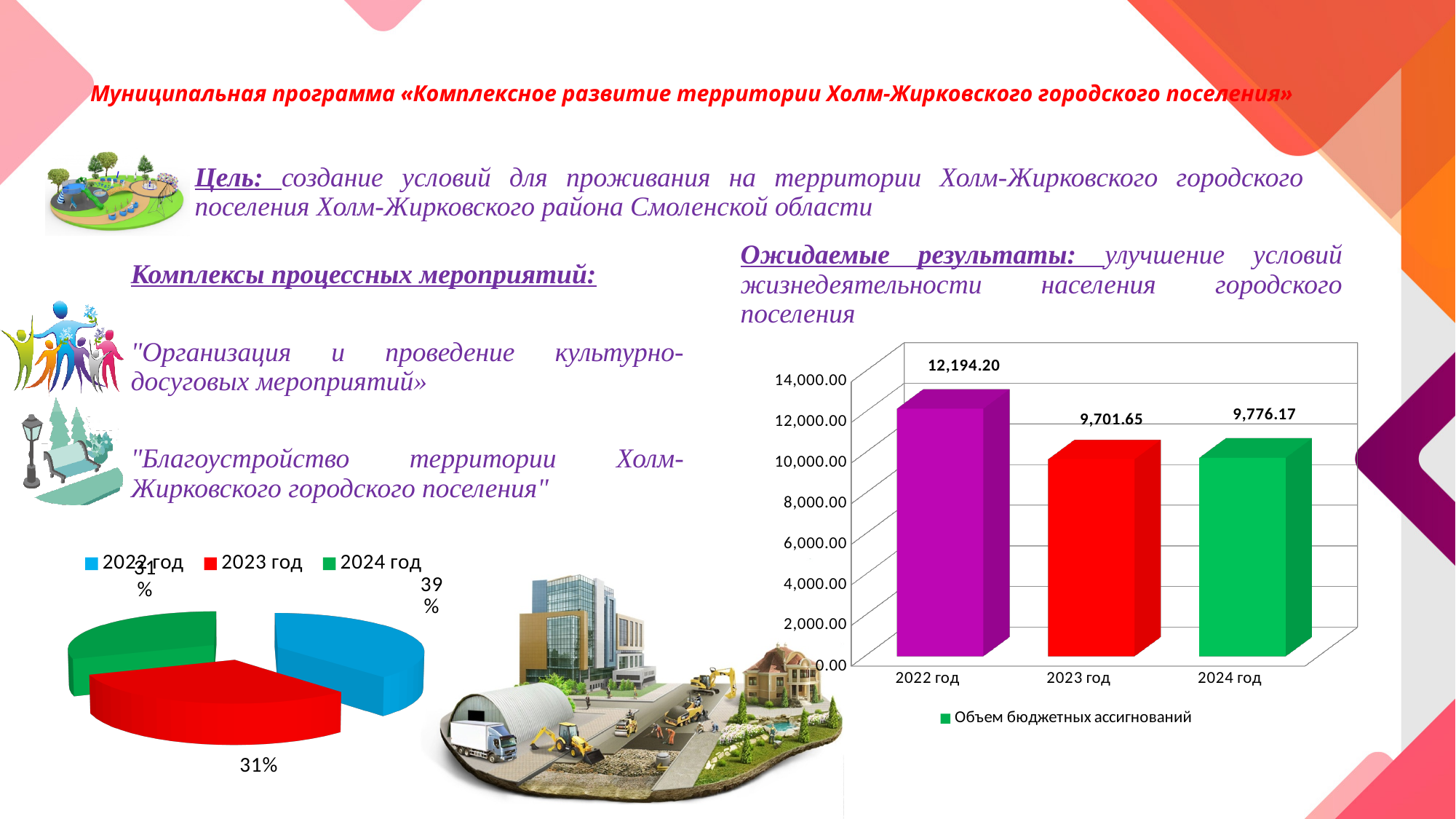
In the bar chart on the right, what is the difference between the values for 2022 год and 2023 год? 2,492.55 In the bar chart on the right, which year has the highest value? 2022 год In the bar chart on the right, how many bars are plotted? 3 In the bar chart on the right, what is the value for 2024 год? 9,776.17 In the bar chart on the right, what is the value for 2023 год? 9,701.65 In the bar chart on the right, which is larger: the value for 2023 год or 2024 год? 2024 год In the bar chart on the right, which year has the lowest value? 2023 год What kind of chart is the chart on the right of the slide? bar chart In the pie chart at the bottom left, what share does 2022 год have? 39% In the bar chart on the right, is the value for 2022 год greater or less than 12,000.00? greater In the pie chart at the bottom left, what share does 2023 год have? 31% In the bar chart on the right, what is the value for 2022 год? 12,194.20